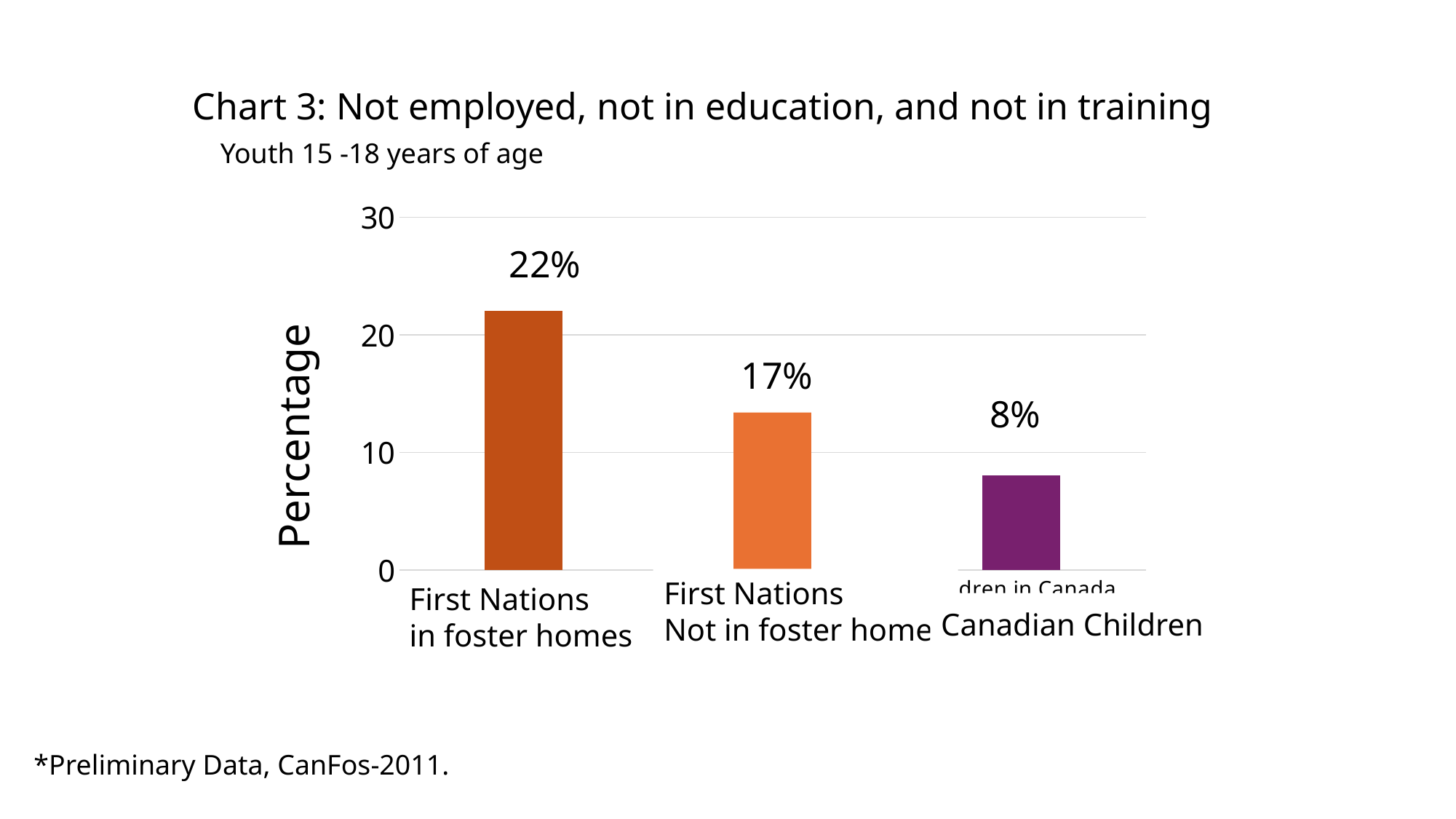
What is the label on the vertical axis? Percentage What is the value for First Nations in foster homes? 22% What is the value for Canadian Children? 8% Which category has the highest value? First Nations in foster homes What is the difference between the values for First Nations in foster homes and Canadian Children? 14% Is the value for Canadian Children greater or less than 10? less What kind of chart is shown on the slide? bar chart Which is larger, the value for First Nations Not in foster home or the value for Canadian Children? First Nations Not in foster home Which category has the lowest value? Canadian Children How many categories are shown in the chart? 3 What is the value for First Nations Not in foster home? 17% What is the difference between the values for First Nations in foster homes and First Nations Not in foster home? 5%